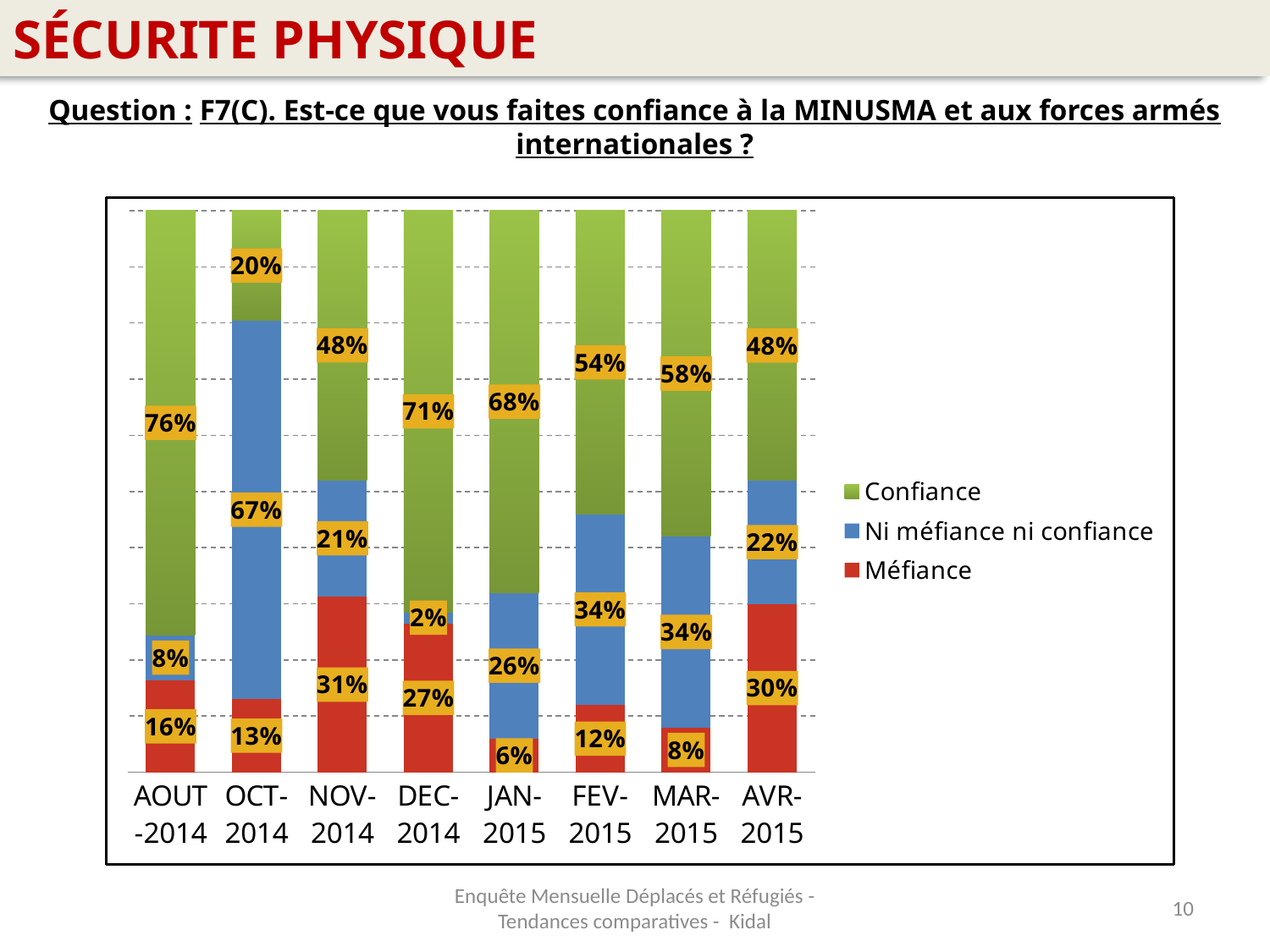
In which month is the Confiance value the lowest? OCT-2014 What is the Confiance value for AOUT-2014? 76% In which month is the Méfiance value the highest? NOV-2014 Which is larger, the Méfiance value for JAN-2015 or for FEV-2015? FEV-2015 What is the Ni méfiance ni confiance value for OCT-2014? 67% What is the Méfiance value for NOV-2014? 31% What is the Ni méfiance ni confiance value for DEC-2014? 2% What is the difference between the Confiance values for AOUT-2014 and OCT-2014? 56% What kind of chart is shown on the slide? Stacked bar chart How many series does the legend list? 3 What is the total of the three segments in the AVR-2015 bar? 100% How many months are shown on the x axis? 8